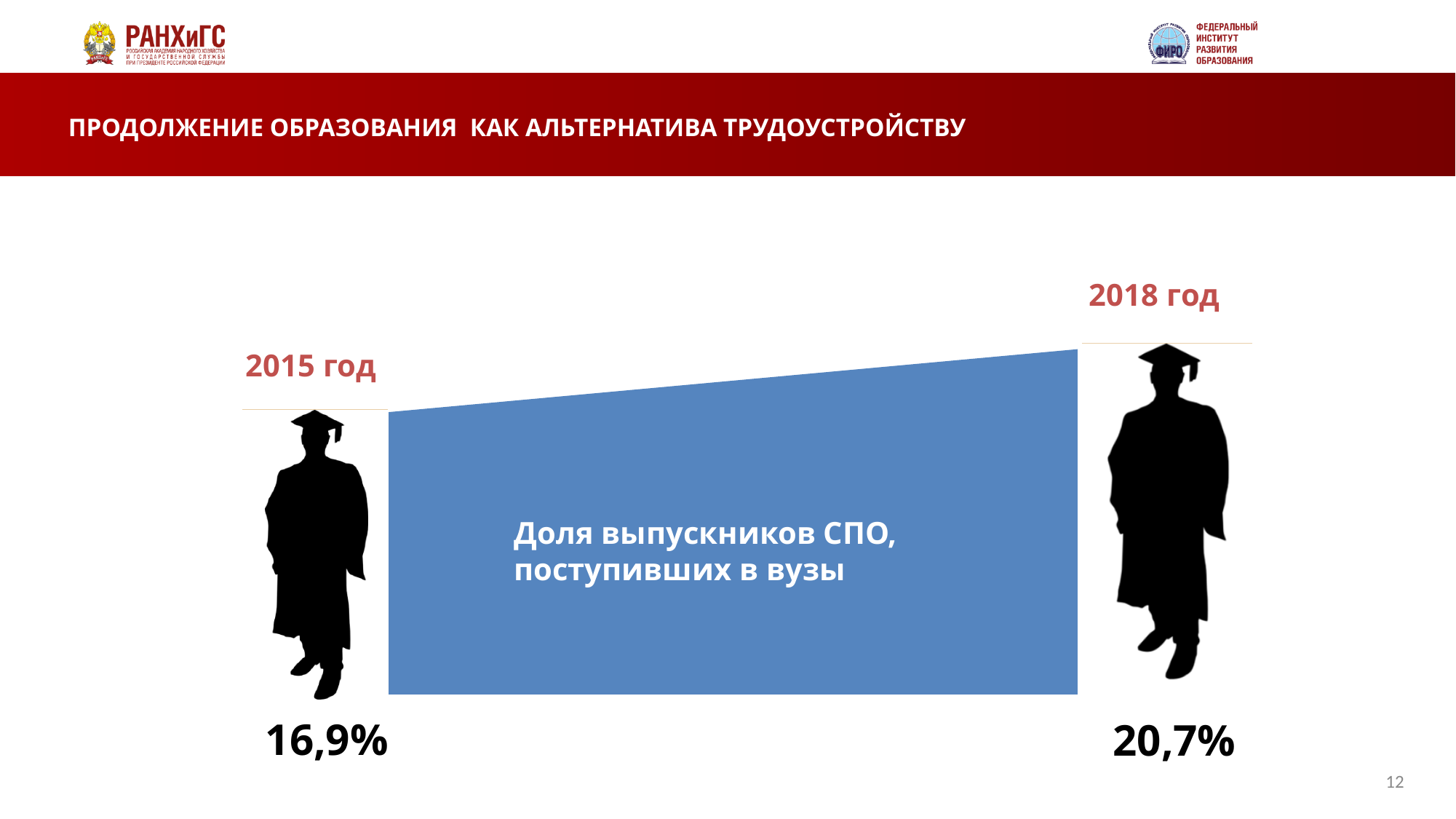
Which year has the highest share of SPO graduates entering universities? 2018 год What is the title of the slide? ПРОДОЛЖЕНИЕ ОБРАЗОВАНИЯ КАК АЛЬТЕРНАТИВА ТРУДОУСТРОЙСТВУ Is the value for 2018 greater or less than 20%? greater How many years are compared in the graphic? 2 Is the value for 2015 greater or less than 20%? less Which year shows the higher share of SPO graduates entering universities, 2015 or 2018? 2018 Does the share of SPO graduates entering universities rise or fall from 2015 to 2018? rise What indicator does the blue shape in the graphic represent? Доля выпускников СПО, поступивших в вузы What is the share of SPO graduates who entered universities in 2018? 20,7% Which year has the lowest share of SPO graduates entering universities? 2015 год What is the share of SPO graduates who entered universities in 2015? 16,9% By how many percentage points did the share of SPO graduates entering universities change from 2015 to 2018? 3,8%